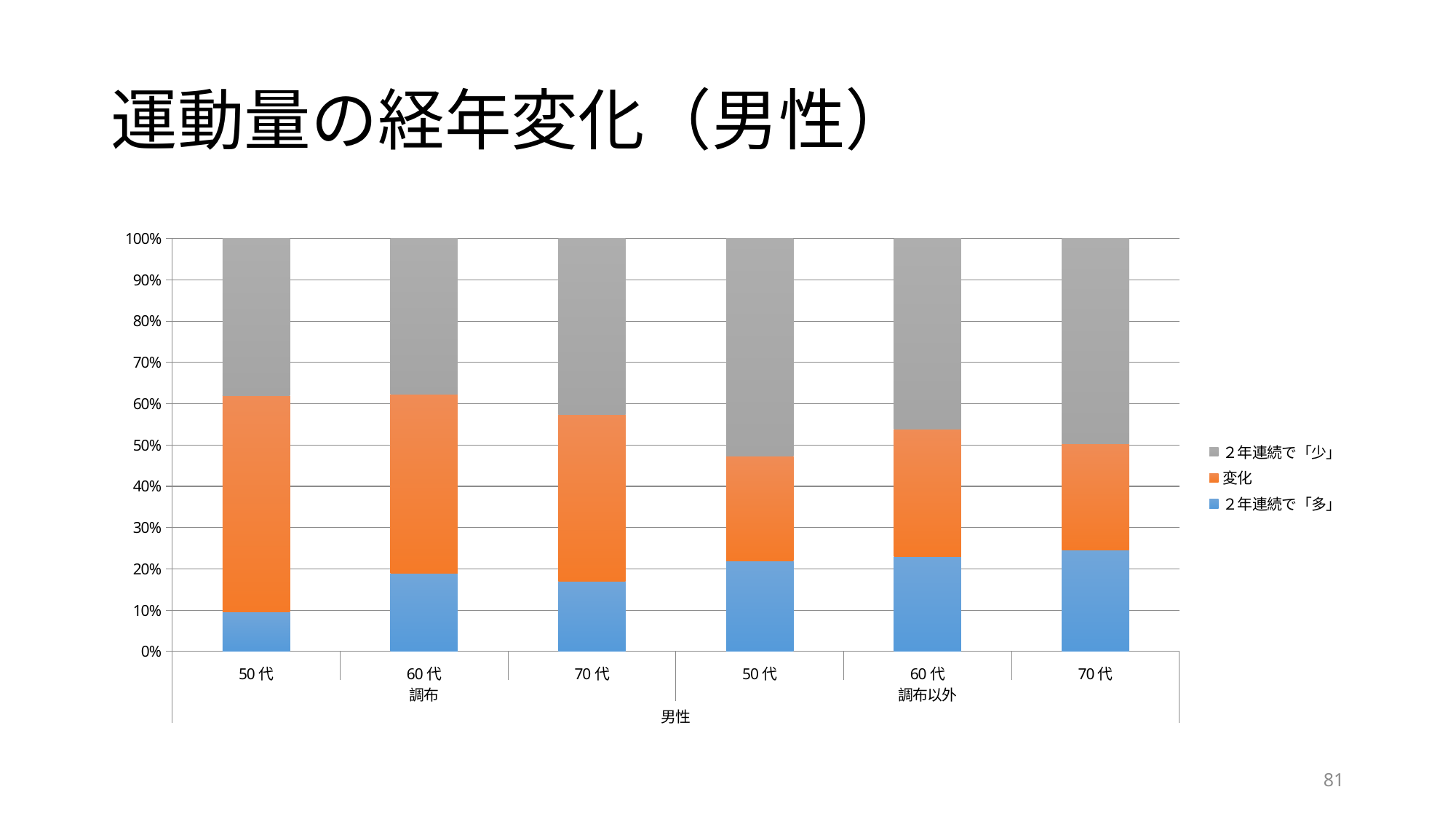
Is the combined share of 2年連続で「多」 and 変化 for 調布 50代 greater or less than 60%? greater Which bar has the largest 2年連続で「少」 (gray) segment? 調布以外 50代 What is the total height of each stacked bar in the chart? 100% How many series does the legend list? 3 Which colour represents the series 変化 in the chart? Orange What kind of chart is shown on the slide? Stacked bar chart Is the combined share of 2年連続で「多」 and 変化 for 調布以外 50代 greater or less than 50%? less Is the 2年連続で「多」 value for 調布以外 70代 greater or less than 20%? greater Which has the larger 2年連続で「多」 segment: 調布 50代 or 調布以外 50代? 調布以外 50代 How many bars are plotted in the chart? 6 What is the title of the slide? 運動量の経年変化（男性） Which bar has the smallest 2年連続で「多」 (blue) segment? 調布 50代